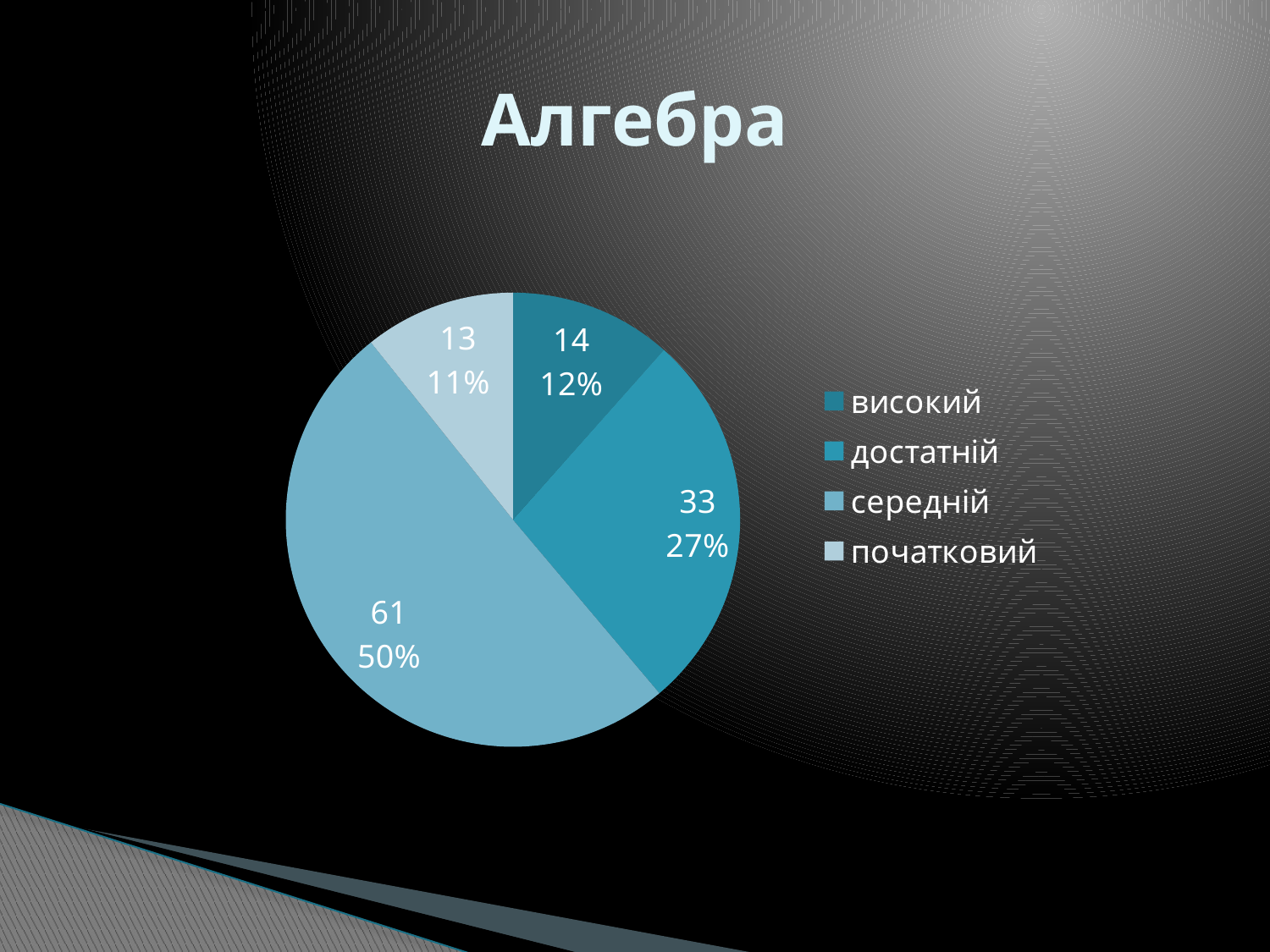
How many entries does the legend list? 4 What is the difference between the values for середній and достатній? 28 What percentage share does початковий have? 11% How many slices does the pie chart have? 4 What is the value for достатній? 33 Which category has the largest slice? середній What is the title of the chart? Алгебра What percentage share does середній have? 50% Which category has the smallest slice? початковий What kind of chart is shown on the slide? pie chart What is the value for середній? 61 What is the value for високий? 14